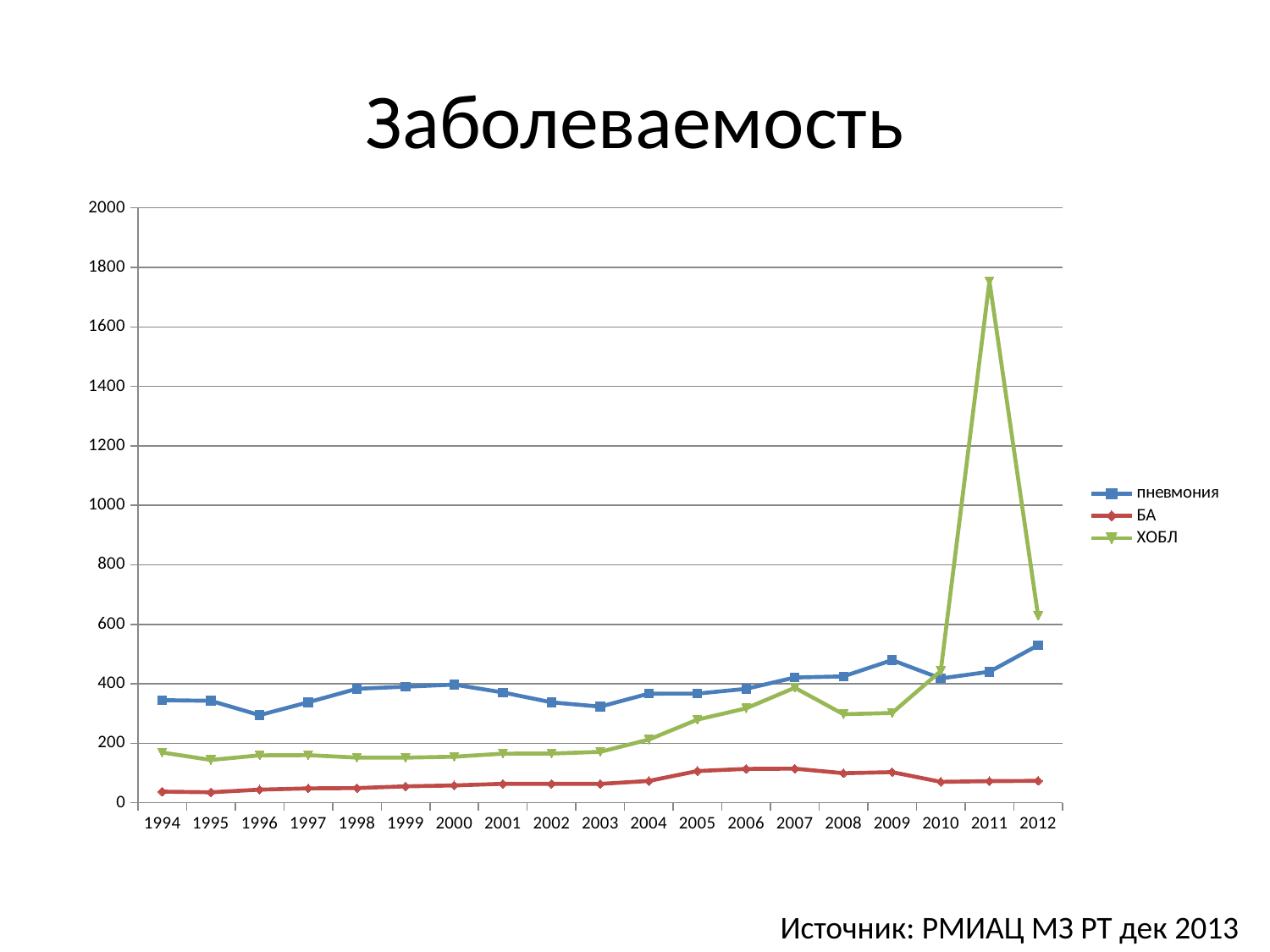
In 1994, which series has the larger value, пневмония or БА? пневмония In 2011, which series has the larger value, ХОБЛ or пневмония? ХОБЛ Is the value for БА in 2007 greater or less than 200? less Which series has the lowest values throughout the whole period? БА Is the value for ХОБЛ in 2011 greater or less than 1600? greater Does the ХОБЛ series rise or fall from 2011 to 2012? fall What is the title of the chart? Заболеваемость What kind of chart is shown on the slide? line chart Is the value for пневмония in 2012 greater or less than 400? greater In which year does the ХОБЛ series reach its highest value? 2011 How many series does the legend list? 3 How many years are shown on the x axis? 19